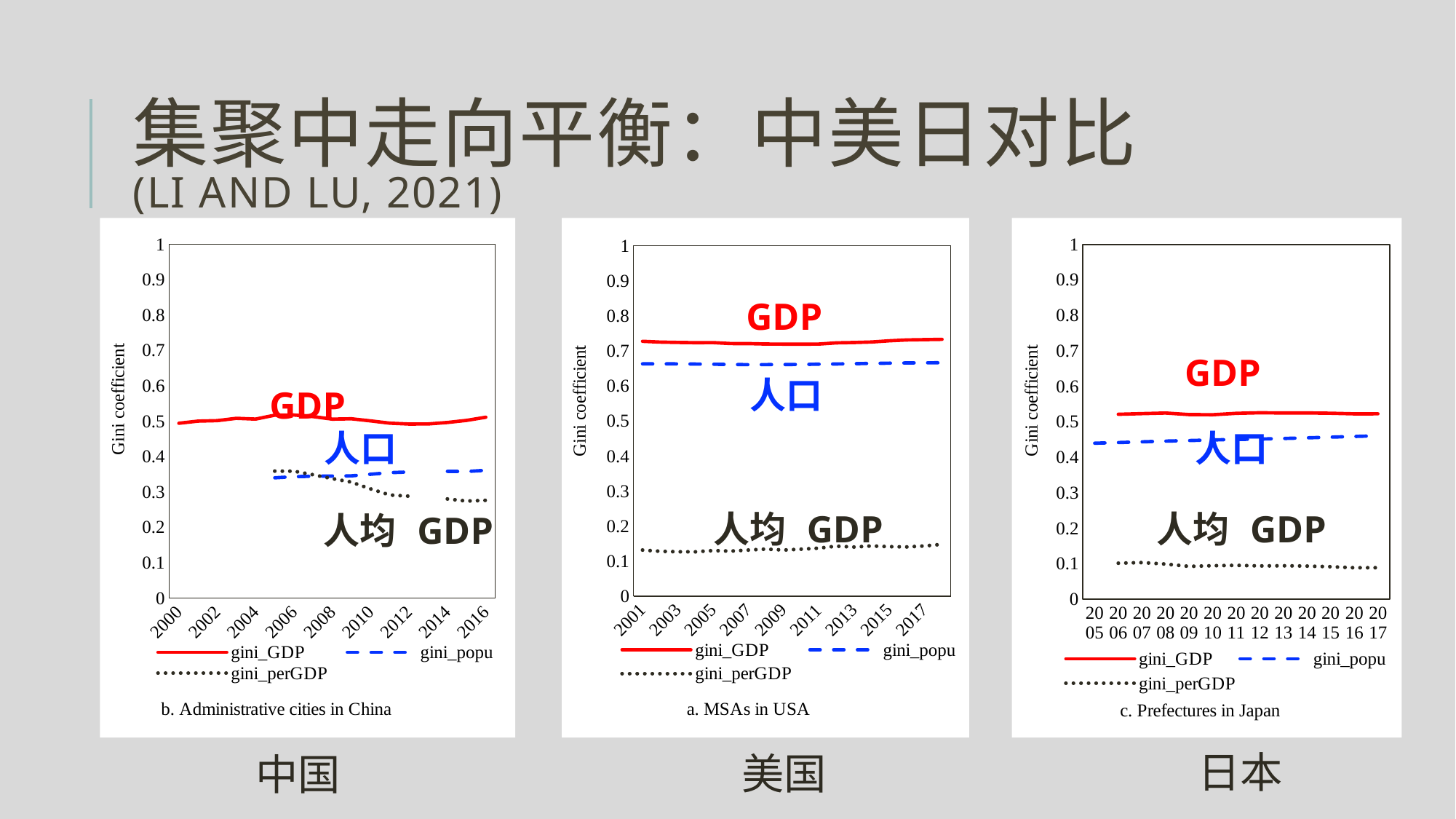
In the chart captioned "c. Prefectures in Japan", which series has the lowest values? gini_perGDP In the chart captioned "c. Prefectures in Japan", is the value of gini_popu greater or less than 0.5? less What kind of chart is the chart captioned "a. MSAs in USA"? line chart In the chart captioned "a. MSAs in USA", which is larger, gini_GDP or gini_popu? gini_GDP In the chart captioned "a. MSAs in USA", is the value of gini_GDP greater or less than 0.7? greater In the chart captioned "a. MSAs in USA", is the value of gini_perGDP greater or less than 0.2? less What is the y-axis label of the chart captioned "c. Prefectures in Japan"? Gini coefficient How many series does the legend list in the chart captioned "b. Administrative cities in China"? 3 In the chart captioned "b. Administrative cities in China", does gini_perGDP rise or fall from 2006 to 2016? fall In the chart captioned "b. Administrative cities in China", which series is drawn as a dashed blue line? gini_popu In the chart captioned "a. MSAs in USA", which series has the highest values? gini_GDP